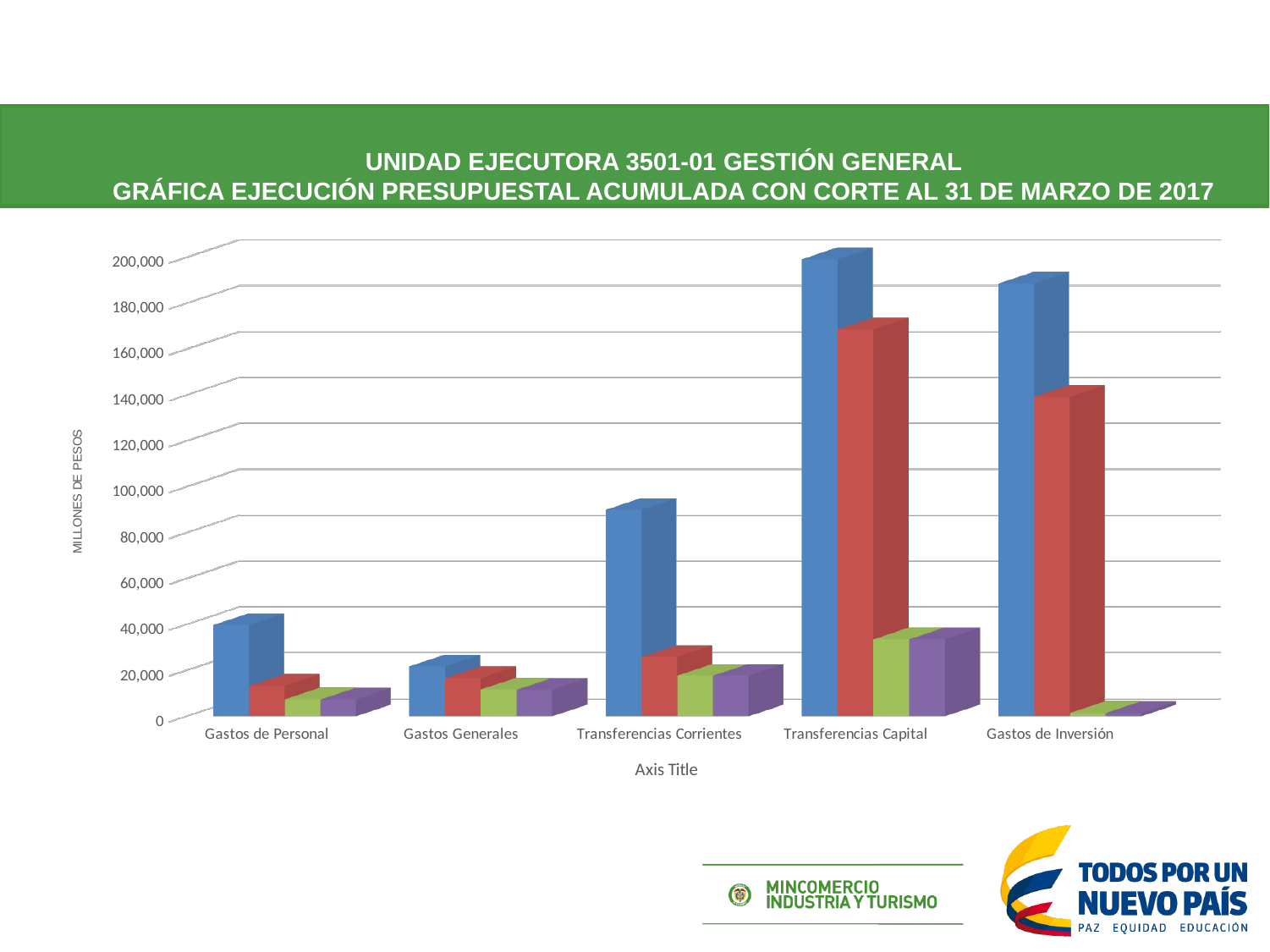
What kind of chart is shown on the slide? bar chart Which category has the shortest blue bar? Gastos Generales Which category has the tallest red bar? Transferencias Capital Which category has the tallest blue bar? Transferencias Capital Is the red bar for Gastos de Inversión greater or less than 120,000? greater What text appears as the horizontal axis title of the chart? Axis Title How many bars are plotted for each category in the chart? 4 What is the title of the vertical axis of the chart? MILLONES DE PESOS How many categories are shown on the x axis of the chart? 5 Is the blue bar for Transferencias Capital greater or less than 180,000? greater Is the blue bar for Transferencias Corrientes greater or less than 100,000? less Which is larger, the blue bar for Gastos de Personal or the blue bar for Gastos Generales? Gastos de Personal